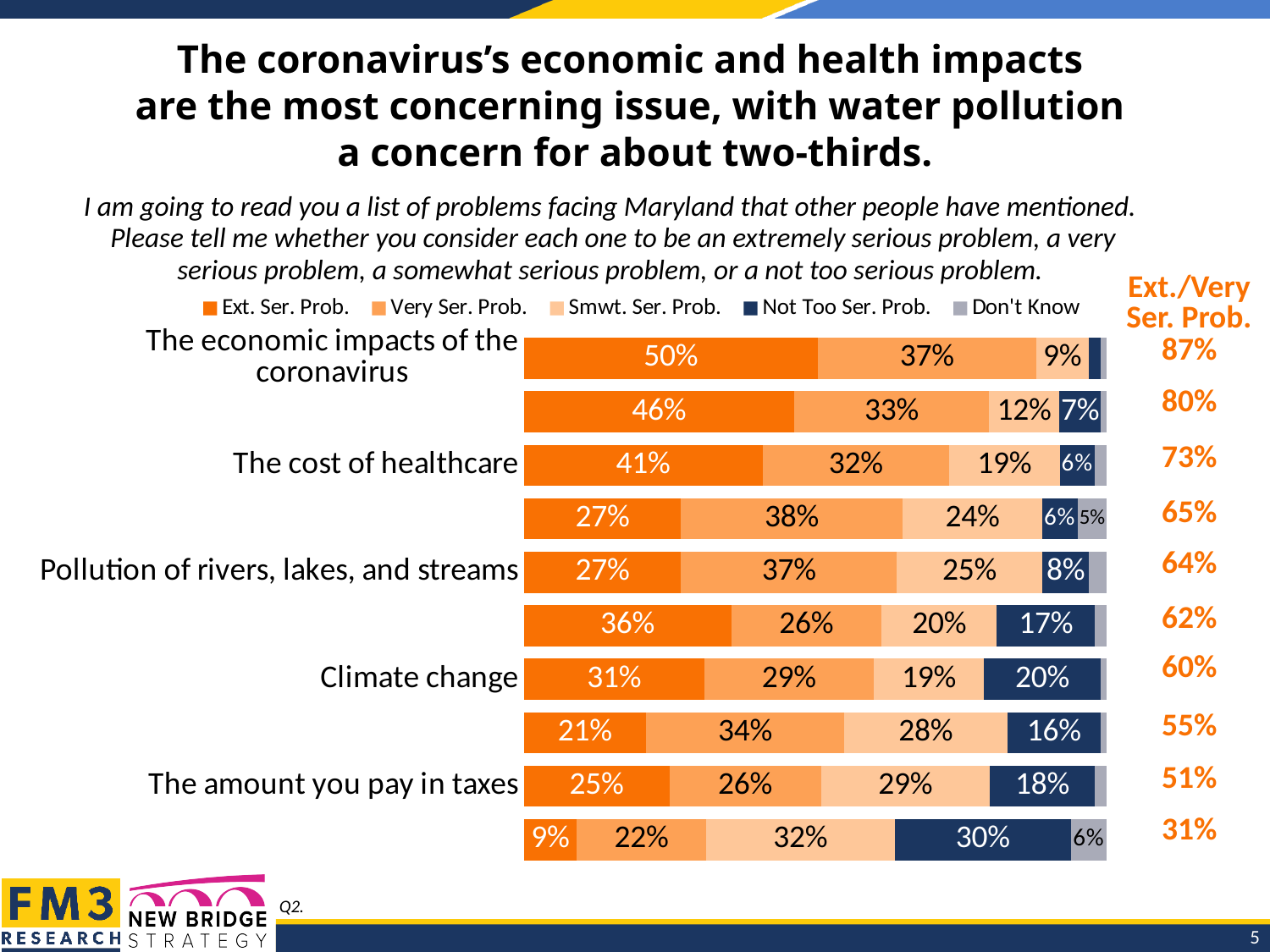
What percentage rated the economic impacts of the coronavirus an extremely serious problem (Ext. Ser. Prob.)? 50% How many bars are plotted in the chart? 10 What is the lowest Ext./Very Ser. Prob. value shown in the right-hand column? 31% Which item has the highest Ext. Ser. Prob. value? The economic impacts of the coronavirus What is the Smwt. Ser. Prob. value for the amount you pay in taxes? 29% What is the Very Ser. Prob. value for the cost of healthcare? 32% What kind of chart is shown on the slide? stacked bar chart What is the difference in Ext. Ser. Prob. between the economic impacts of the coronavirus and the cost of healthcare? 9 percentage points What is the Not Too Ser. Prob. value for climate change? 20% How many series does the legend list? 5 What is the Ext./Very Ser. Prob. value for pollution of rivers, lakes, and streams? 64% Which has a larger Ext. Ser. Prob. value, climate change or the amount you pay in taxes? Climate change